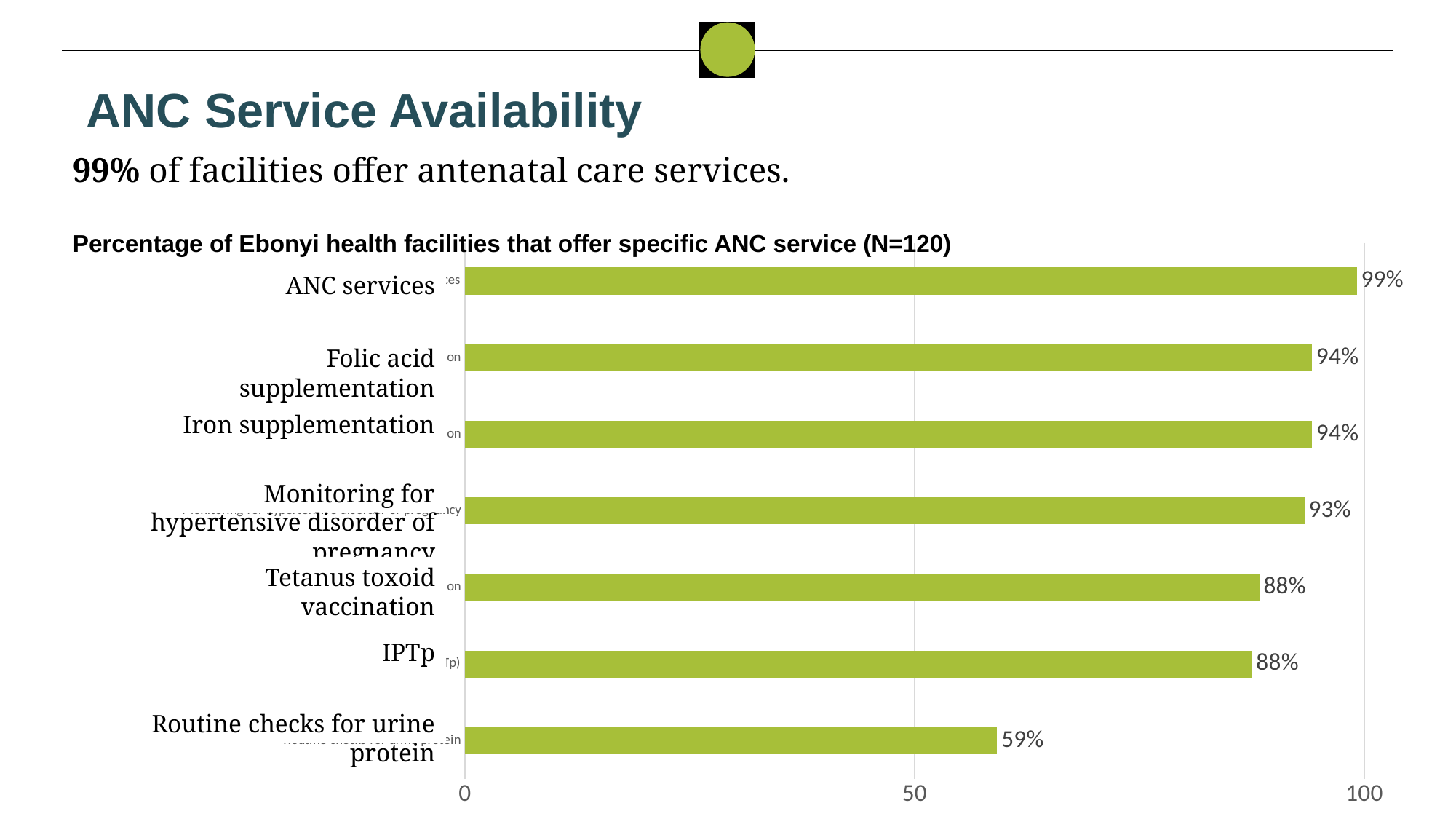
What percentage of facilities offer monitoring for hypertensive disorder of pregnancy? 93% What is the sample size (N) stated in the chart title? 120 How many ANC services are shown in the chart? 7 What percentage of facilities offer routine checks for urine protein? 59% Which ANC service has the highest percentage of facilities offering it? ANC services Which is larger: the percentage for folic acid supplementation or for IPTp? Folic acid supplementation What percentage of facilities offer tetanus toxoid vaccination? 88% What percentage of facilities offer ANC services? 99% Is the value for routine checks for urine protein greater or less than 50? greater Which ANC service has the lowest percentage of facilities offering it? Routine checks for urine protein What kind of chart is shown on the slide? Bar chart What is the difference in percentage points between ANC services and routine checks for urine protein? 40